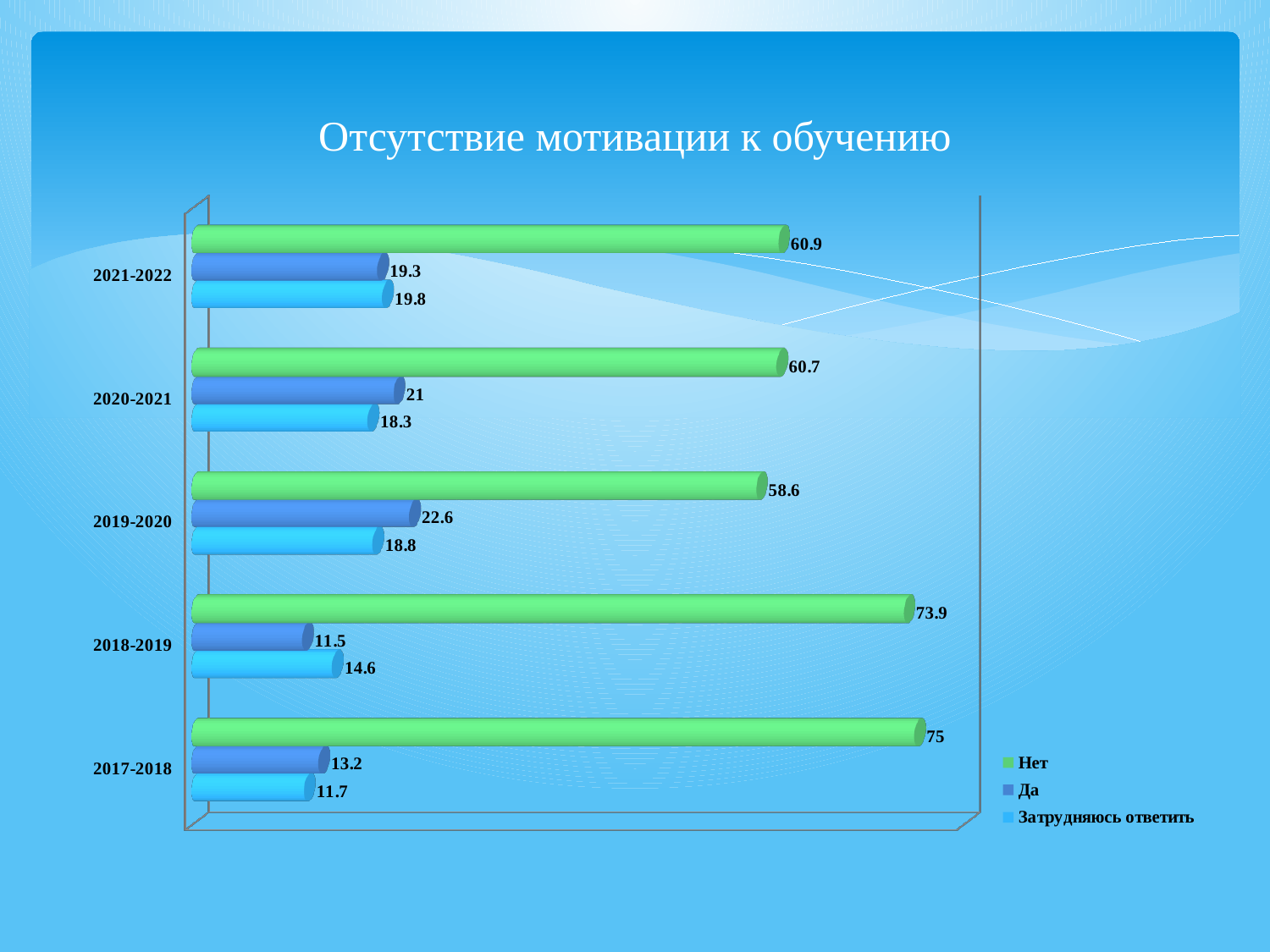
What is the value for "Да" in 2020-2021? 21 How many year categories are shown on the chart? 5 Which is larger in 2021-2022: the value for "Да" or for "Затрудняюсь ответить"? Затрудняюсь ответить What kind of chart is shown on the slide? Bar chart What is the value for "Да" in 2019-2020? 22.6 What is the difference between the "Нет" values for 2017-2018 and 2018-2019? 1.1 What is the title of the chart? Отсутствие мотивации к обучению How many series does the legend list? 3 In which year is the value for "Нет" the highest? 2017-2018 In which year is the value for "Да" the lowest? 2018-2019 What is the value for "Затрудняюсь ответить" in 2018-2019? 14.6 What is the value for "Нет" in 2021-2022? 60.9